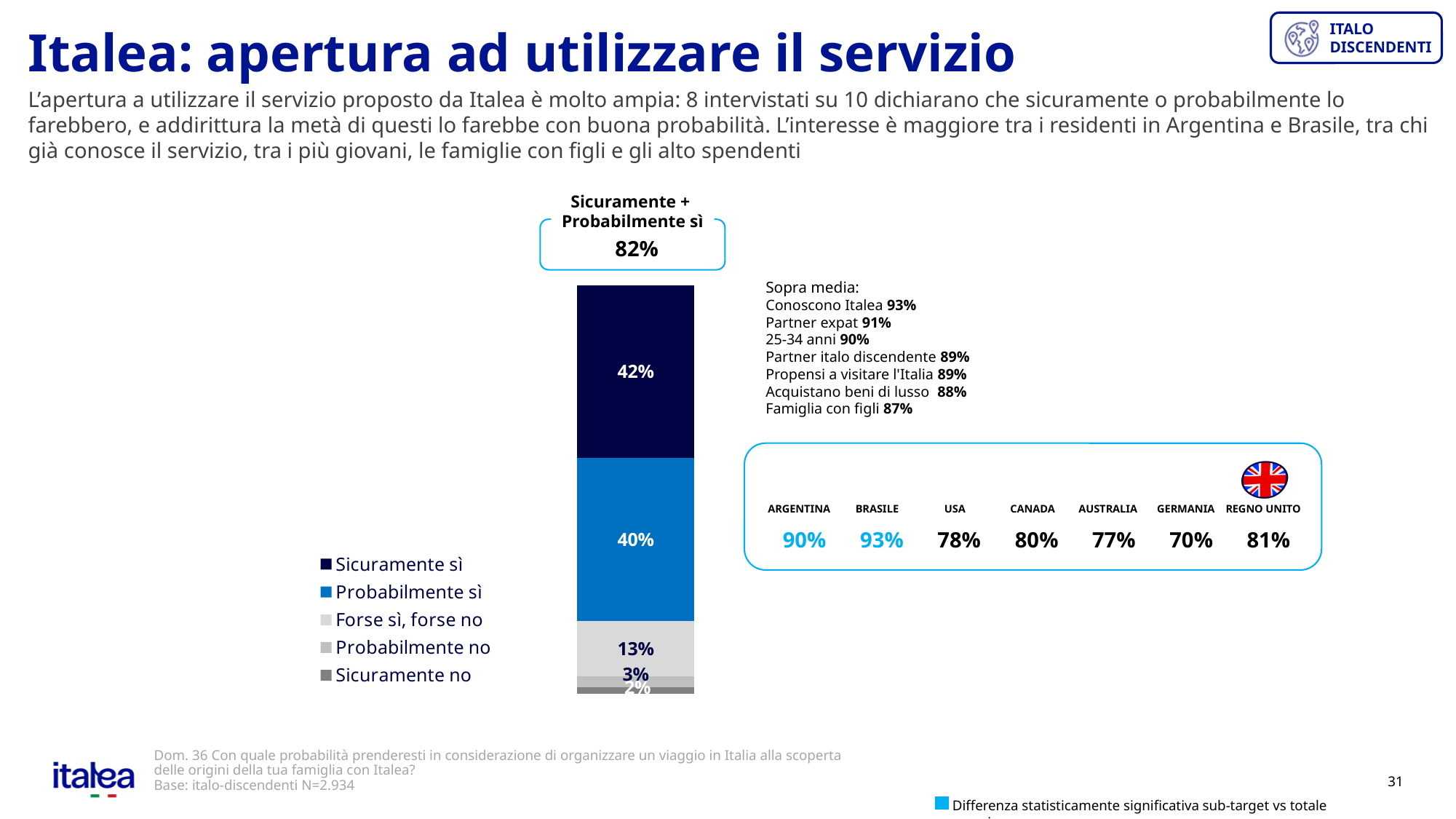
What is the combined value of "Sicuramente sì" and "Probabilmente sì" shown above the bar? 82% What is the difference between the "Sicuramente sì" and "Probabilmente sì" segments? 2% Which response category has the smallest share in the stacked bar? Sicuramente no What percentage of respondents answered "Sicuramente sì" in the stacked bar chart? 42% Which response category has the largest share in the stacked bar? Sicuramente sì What is the value shown for "Probabilmente no"? 3% What is the value shown for "Forse sì, forse no"? 13% Which is larger: the "Forse sì, forse no" segment or the "Probabilmente no" segment? Forse sì, forse no How many series does the legend of the stacked bar chart list? 5 What is the value shown for "Sicuramente no"? 2% What percentage of respondents answered "Probabilmente sì"? 40% What type of chart is used to show the response distribution? Stacked bar chart